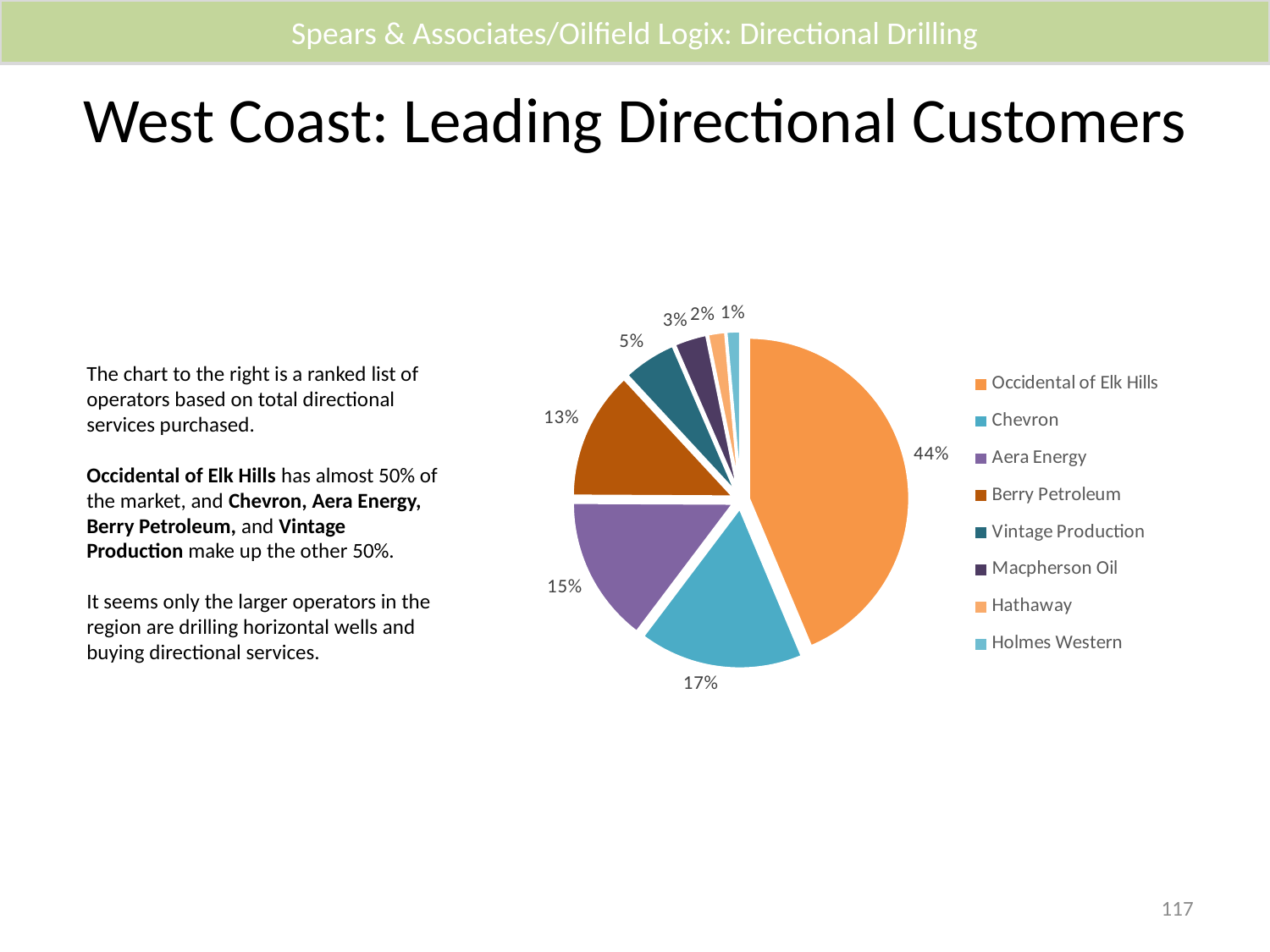
Which operator has the smallest slice of the pie? Holmes Western Which is larger, the share for Berry Petroleum or the share for Vintage Production? Berry Petroleum Which operator has the largest slice of the pie? Occidental of Elk Hills What share of the pie does Occidental of Elk Hills hold? 44% What is the value shown for Vintage Production? 5% Which legend entry is listed directly after Macpherson Oil? Hathaway How many operators are shown in the pie chart? 8 What is the value shown for Aera Energy? 15% What type of chart is shown on the slide? Pie chart What is the value shown for Chevron? 17% What is the difference between the shares of Chevron and Aera Energy? 2% What is the value shown for Berry Petroleum? 13%